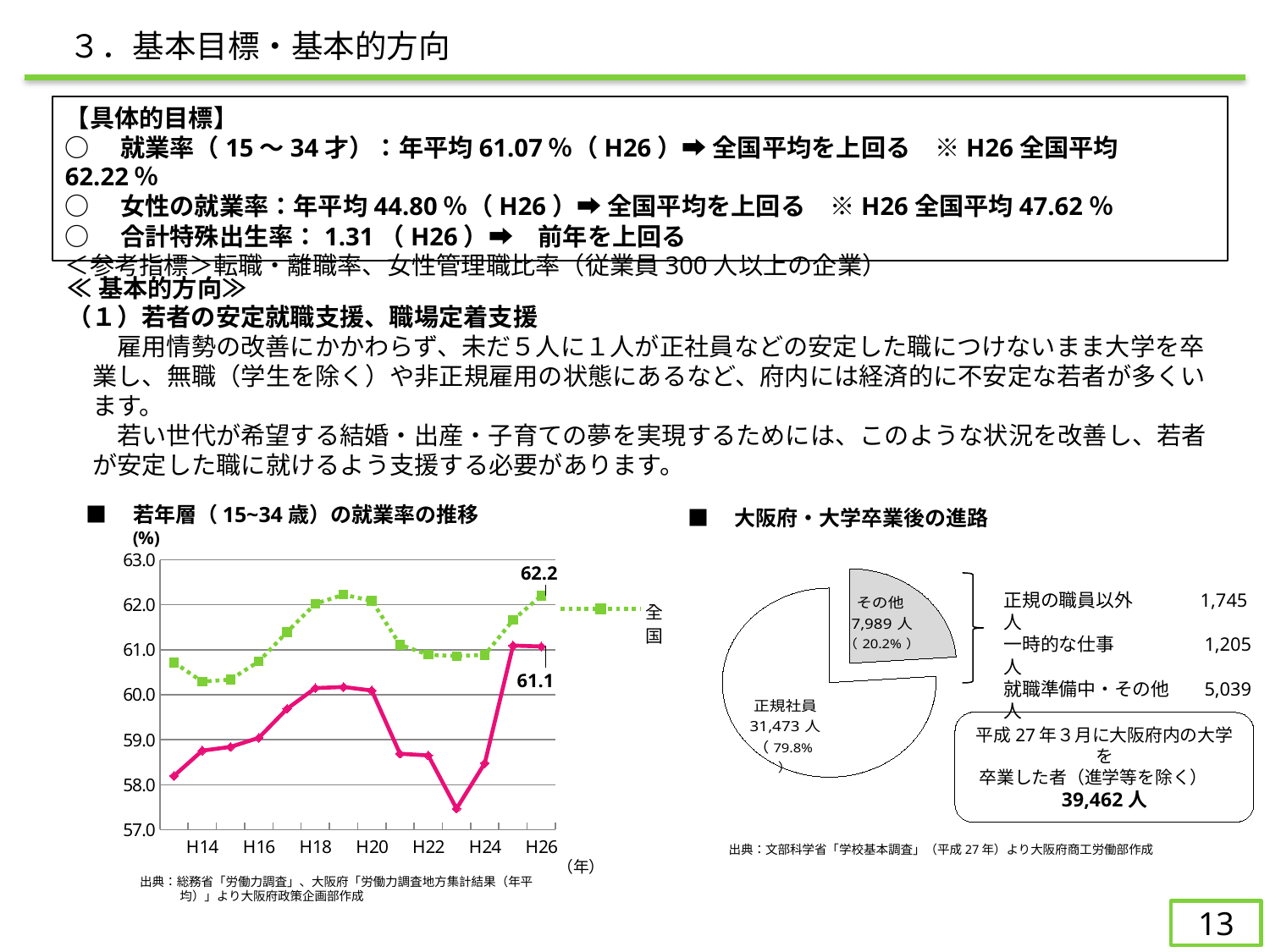
In the line chart 若年層（15~34歳）の就業率の推移, is the lowest point of the solid pink line (at H23) greater or less than 58.0? less In the line chart 若年層（15~34歳）の就業率の推移, what value is labelled on the solid pink line at H26? 61.1 In the pie chart 大阪府・大学卒業後の進路, which slice is larger, 正規社員 or その他? 正規社員 In the pie chart 大阪府・大学卒業後の進路, what is the total number of graduates shown? 39,462人 In the pie chart 大阪府・大学卒業後の進路, how many people are 正規社員? 31,473人 In the chart 大阪府・大学卒業後の進路, how many people are listed under 就職準備中・その他? 5,039人 In the line chart 若年層（15~34歳）の就業率の推移, is the 全国 value at H14 greater or less than 60.0? greater In the line chart 若年層（15~34歳）の就業率の推移, what is the value labelled for 全国 at H26? 62.2 What kind of chart is 若年層（15~34歳）の就業率の推移? line chart In the line chart 若年層（15~34歳）の就業率の推移, how many year labels are shown on the x axis? 7 In the line chart 若年層（15~34歳）の就業率の推移, what is the difference between the two labelled H26 values, 62.2 and 61.1? 1.1 In the pie chart 大阪府・大学卒業後の進路, what share of the pie is その他? 20.2%